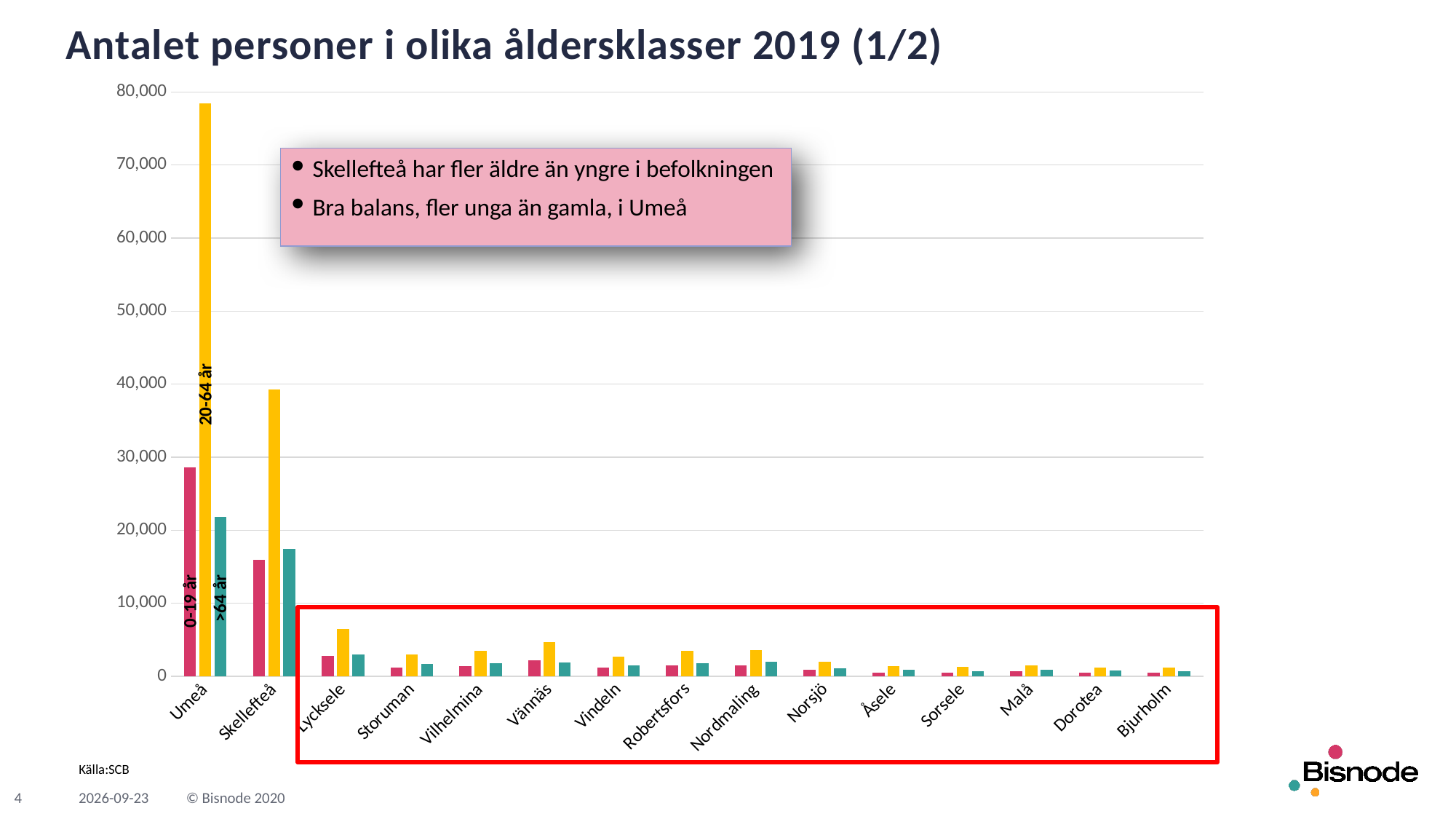
Is the value for 20-64 år in Umeå greater or less than 70,000? greater In Umeå, which is larger: the 0-19 år bar or the >64 år bar? 0-19 år What kind of chart is shown on the slide? Bar chart Which municipality has the tallest bar in the chart? Umeå How many municipalities are shown along the x axis of the chart? 15 What is the title of the chart on the slide? Antalet personer i olika åldersklasser 2019 (1/2) Is the value for >64 år in Umeå greater or less than 20,000? greater Is the value for 0-19 år in Umeå greater or less than 30,000? less In Skellefteå, which is larger: the 0-19 år bar or the >64 år bar? >64 år How many age groups (series) are plotted in the chart? 3